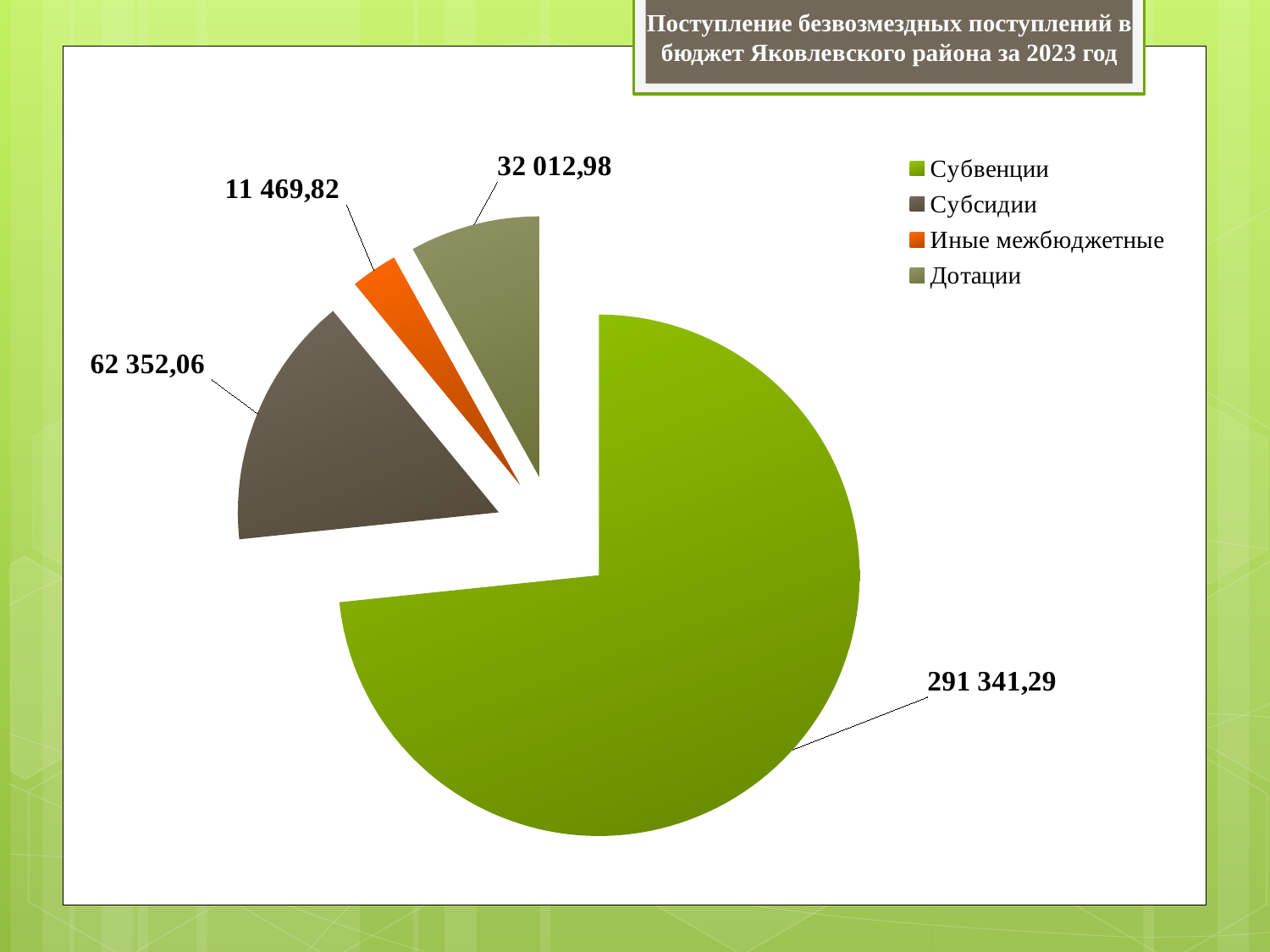
Which category has the largest slice of the pie? Субвенции What is the value for Иные межбюджетные? 11 469,82 Which category has the smallest slice of the pie? Иные межбюджетные What is the difference between the values for Субсидии and Дотации? 30 339,08 Which is larger, Субсидии or Дотации? Субсидии How many slices does the pie chart have? 4 What is the value for Дотации? 32 012,98 What type of chart is shown on the slide? pie chart What is the value for Субсидии? 62 352,06 What colour is the slice for Иные межбюджетные? orange How many entries does the legend list? 4 What is the value for Субвенции? 291 341,29